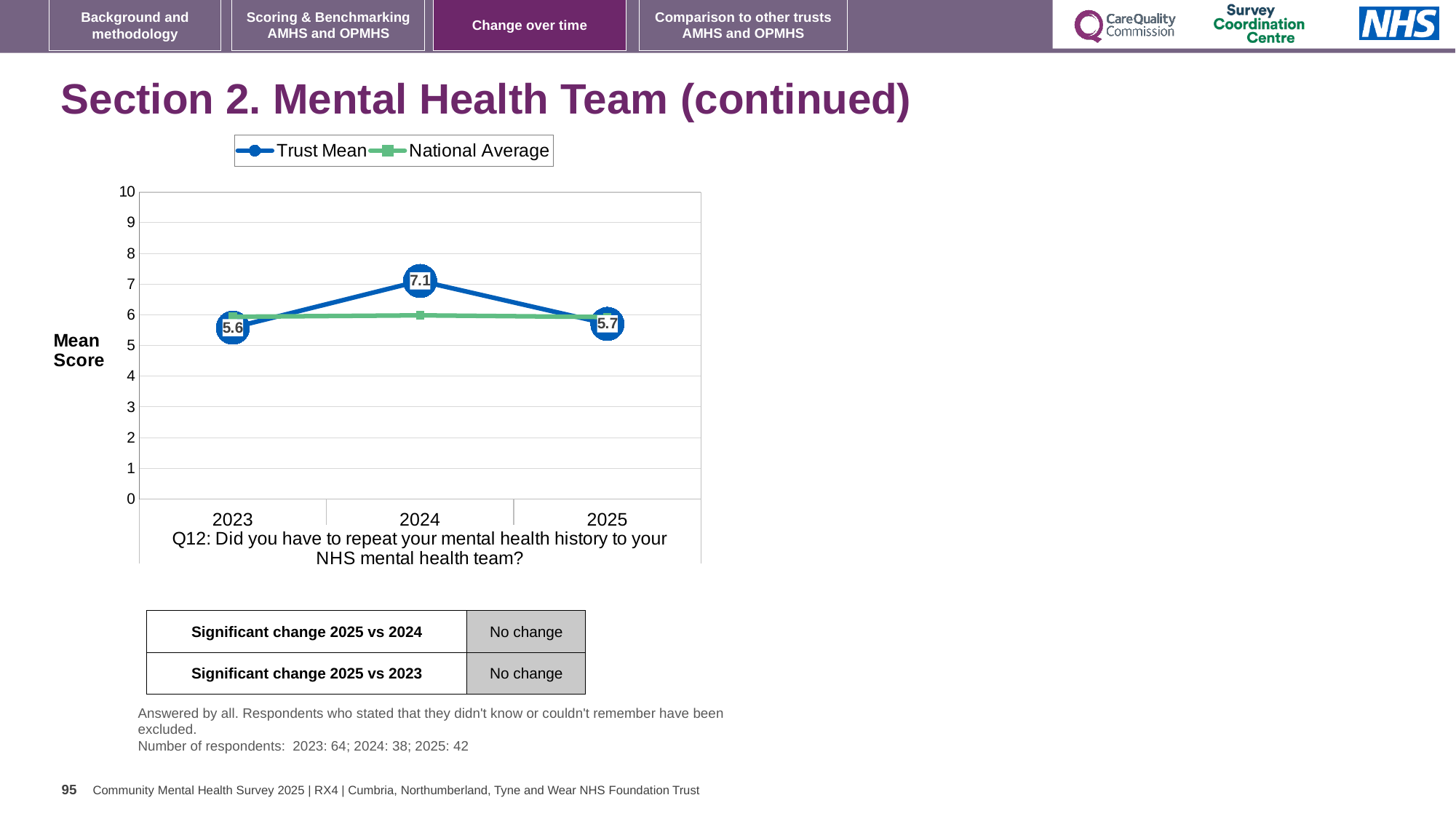
What is the Trust Mean value for 2023? 5.6 What is the difference between the Trust Mean in 2024 and in 2023? 1.5 What is the label on the y axis of the chart? Mean Score What is the Trust Mean value for 2025? 5.7 How many years are shown on the x axis? 3 How many series does the legend list? 2 Is the National Average value for 2024 greater or less than 5? greater Which is larger, the Trust Mean in 2024 or the Trust Mean in 2025? 2024 In which year is the Trust Mean highest? 2024 What kind of chart is shown on the slide? line chart In which year is the Trust Mean lowest? 2023 What is the Trust Mean value for 2024? 7.1